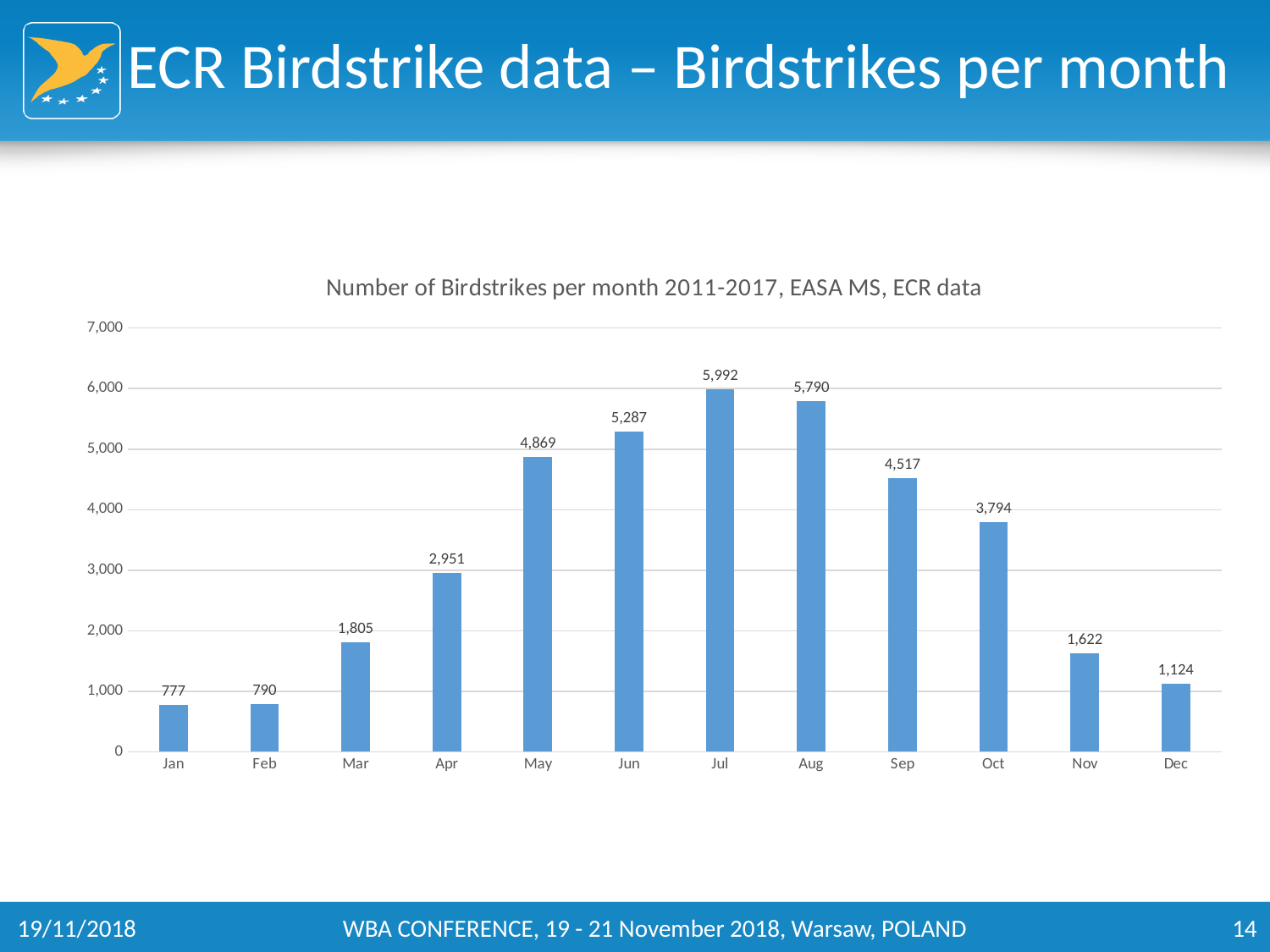
What is the difference between the number of birdstrikes in Jul and Aug? 202 What is the number of birdstrikes for Oct? 3,794 Which month has more birdstrikes, Sep or Oct? Sep What kind of chart is shown on the slide? Bar chart Which month has the highest number of birdstrikes? Jul What is the title of the chart? Number of Birdstrikes per month 2011-2017, EASA MS, ECR data What is the number of birdstrikes for Mar? 1,805 How many months are shown on the x axis? 12 Is the value for Jun greater or less than 5,000? greater What is the difference between the number of birdstrikes in May and Apr? 1,918 Which month has the lowest number of birdstrikes? Jan What is the number of birdstrikes for Jul? 5,992